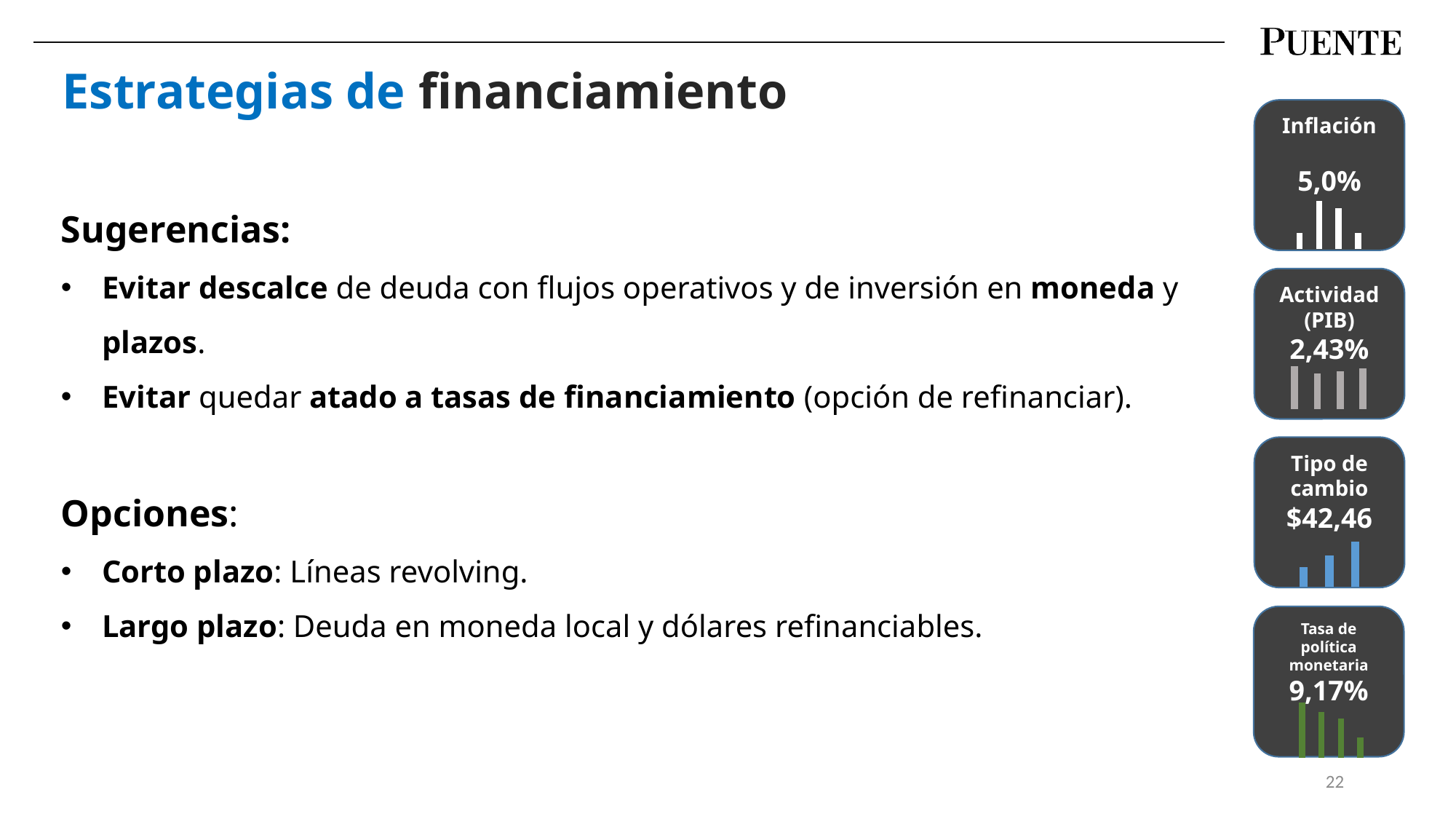
What colour are the bars in the Tipo de cambio box? Blue How many bars does the small chart in the Tasa de política monetaria box contain? 4 In the Tipo de cambio chart, is the first bar or the last bar taller? The last bar In the Tasa de política monetaria box, do the bars rise or fall from left to right? Fall What kind of chart is shown in the Inflación box? Bar chart What value is displayed in the Inflación box? 5,0% How many bars does the small chart in the Tipo de cambio box contain? 3 What value is displayed in the Actividad (PIB) box? 2,43% What value is displayed in the Tipo de cambio box? $42,46 In the Tasa de política monetaria chart, is the first bar or the last bar taller? The first bar What value is displayed in the Tasa de política monetaria box? 9,17% In the Tipo de cambio box, do the bars rise or fall from left to right? Rise